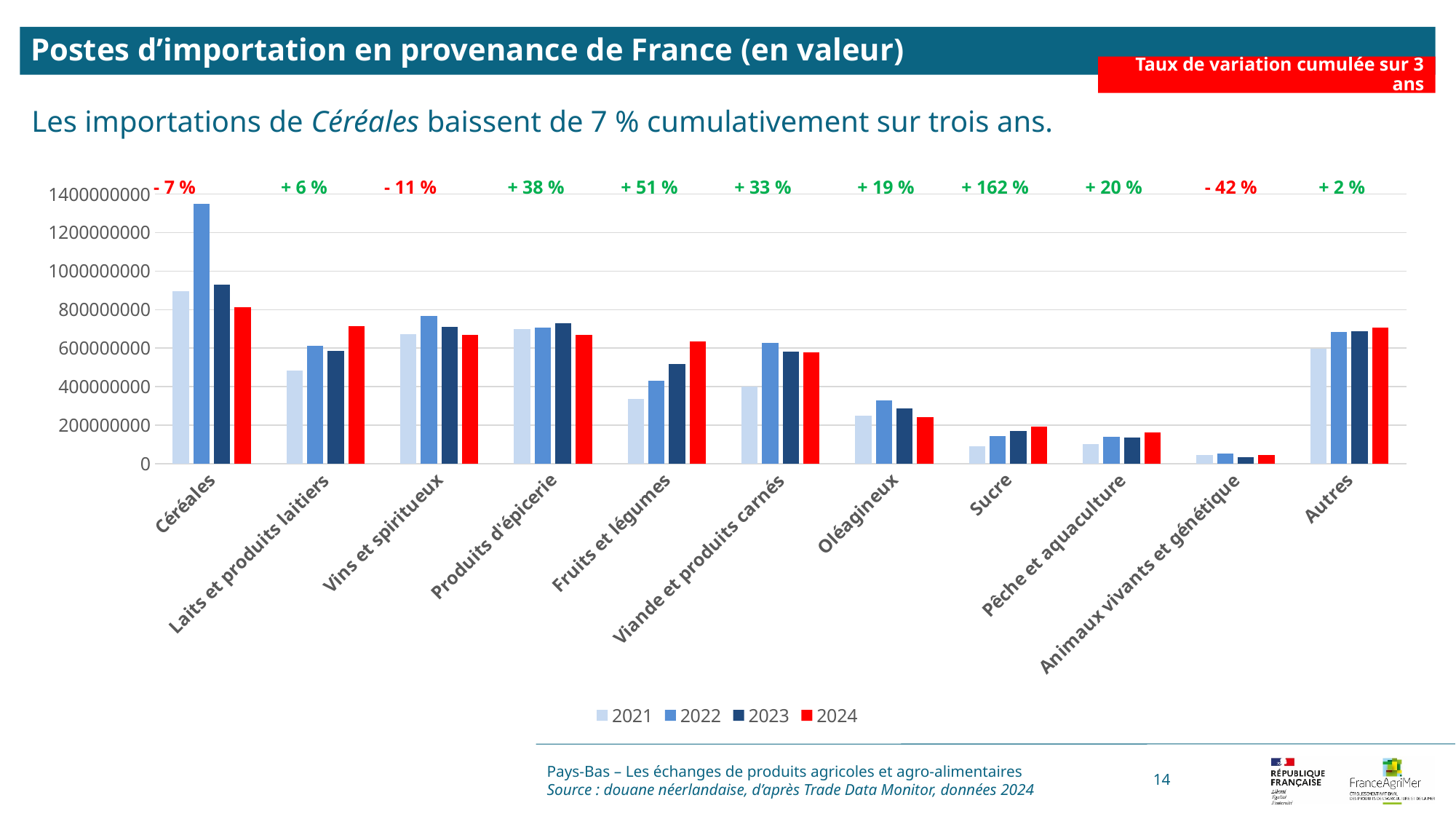
Which category has the highest cumulative variation rate over 3 years? Sucre How many product categories are shown on the x axis? 11 Which colour represents the 2024 series in the legend? red For Céréales, which is larger: the 2021 value or the 2022 value? 2022 Which category has the lowest cumulative variation rate over 3 years? Animaux vivants et génétique What is the cumulative variation rate over 3 years printed above Animaux vivants et génétique? - 42 % Is the 2021 value for Pêche et aquaculture greater or less than 200000000? less What kind of chart is shown on the slide? bar chart How many series does the legend list? 4 What is the cumulative variation rate over 3 years printed above Sucre? + 162 % Is the 2022 value for Céréales greater or less than 1200000000? greater What is the cumulative variation rate over 3 years printed above Vins et spiritueux? - 11 %